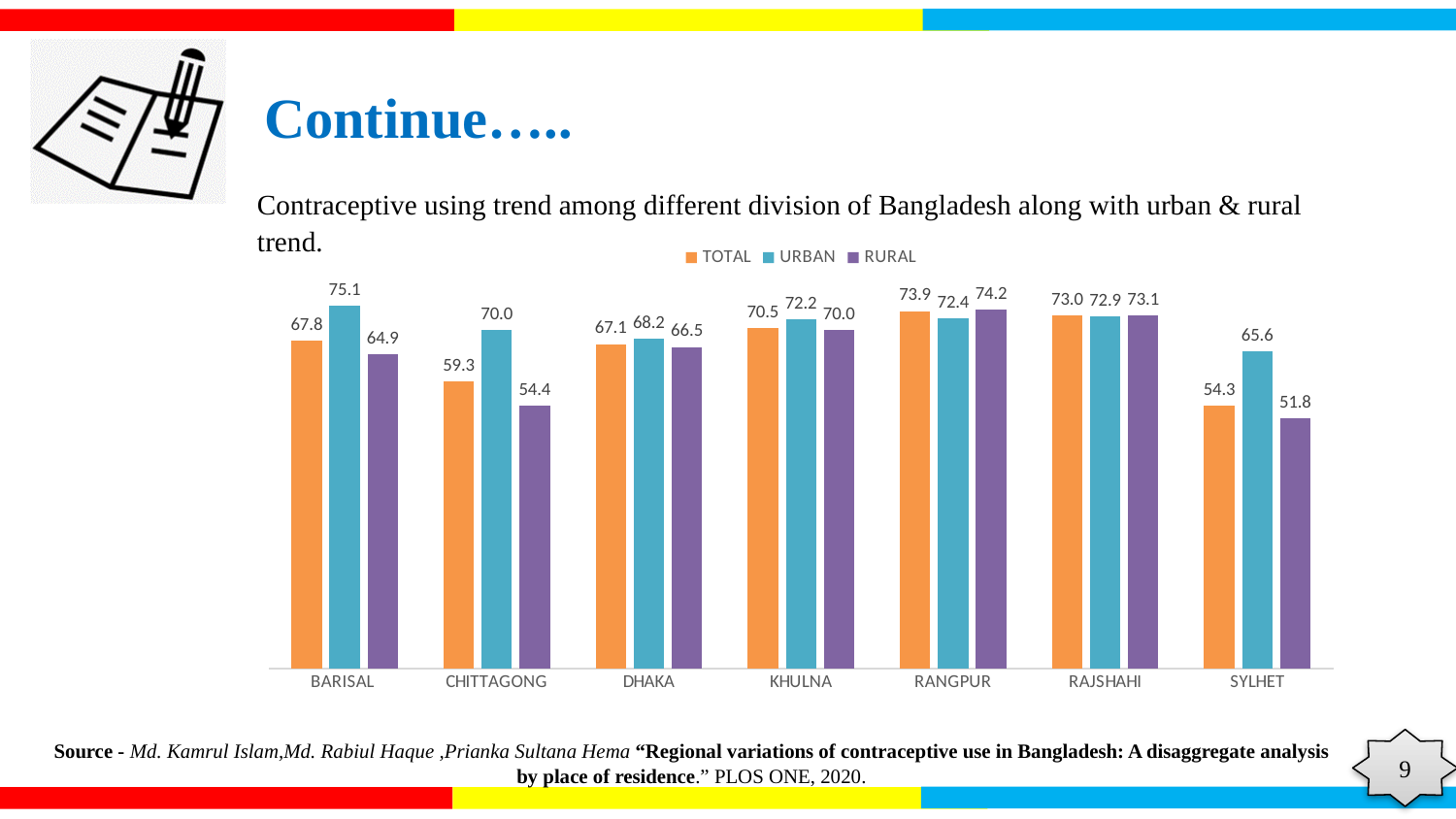
Which is larger, the RURAL value for Rangpur or the RURAL value for Khulna? Rangpur Which series is shown in purple in the legend? RURAL Which division has the highest URBAN value? Barisal How many series does the legend list? 3 Which division has the lowest TOTAL value? Sylhet What kind of chart is shown on the slide? Bar chart What is the RURAL value for Sylhet? 51.8 What is the difference between the TOTAL values for Rangpur and Sylhet? 19.6 What is the TOTAL value for Barisal? 67.8 What is the URBAN value for Chittagong? 70.0 How many divisions are shown on the x axis? 7 What is the difference between the URBAN and RURAL values for Chittagong? 15.6